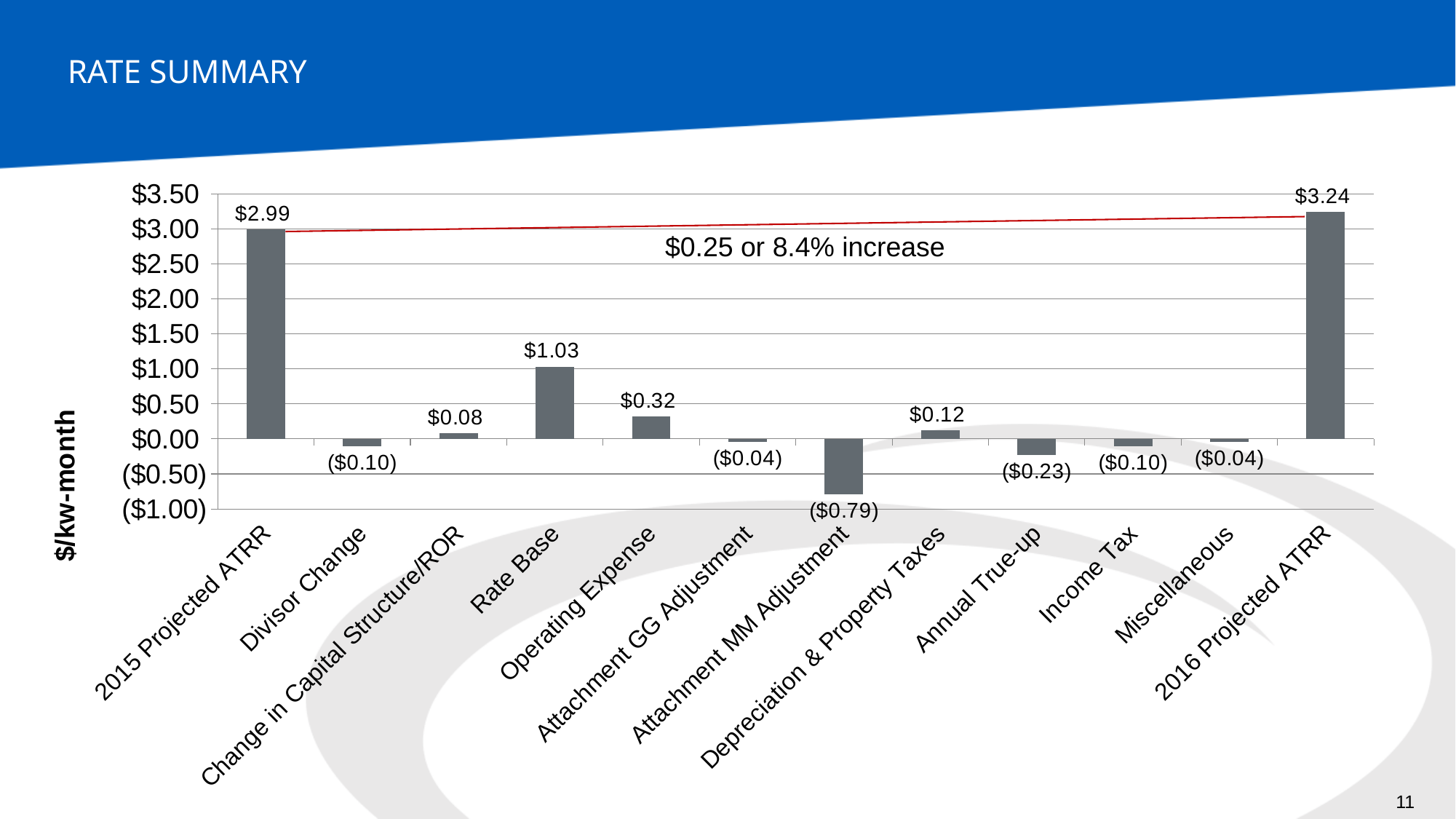
What is the label on the vertical axis? $/kw-month Which category has the highest value? 2016 Projected ATRR Which is larger, the value for Operating Expense or the value for Depreciation & Property Taxes? Operating Expense What kind of chart is this? Bar chart How many categories are shown on the x axis? 12 What is the difference between the 2016 Projected ATRR and the 2015 Projected ATRR? $0.25 What is the value for 2015 Projected ATRR? $2.99 Which category has the lowest value? Attachment MM Adjustment What is the value for Annual True-up? ($0.23) What is the value for 2016 Projected ATRR? $3.24 What is the value for Rate Base? $1.03 What is the value for Attachment MM Adjustment? ($0.79)